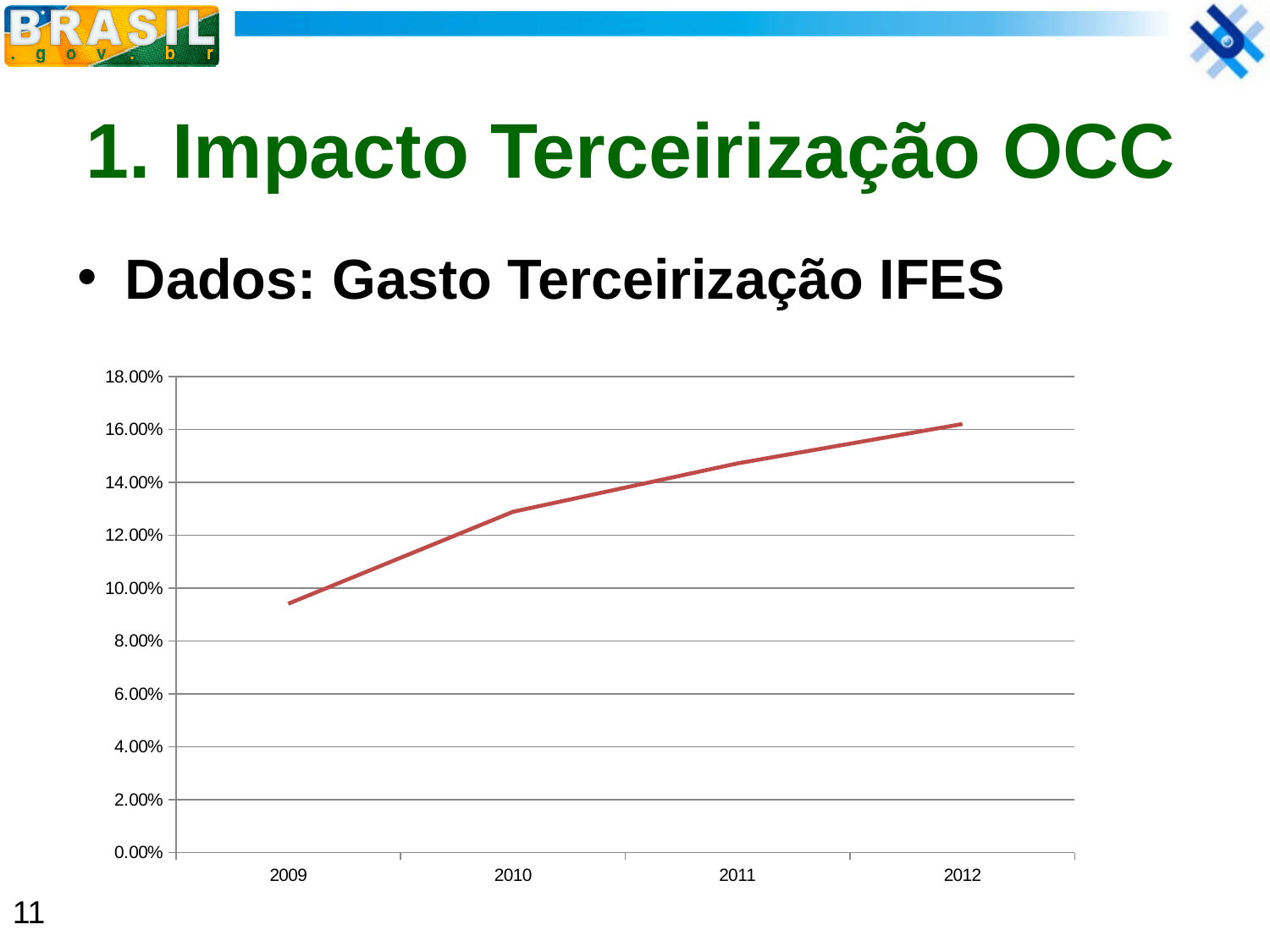
Is the value for 2009 greater or less than 10.00%? less Is the value for 2010 greater or less than 14.00%? less How many years are plotted on the x axis of the chart? 4 What kind of chart is shown on the slide? line chart Which is larger, the value for 2010 or the value for 2012? 2012 Is the value for 2011 greater or less than 14.00%? greater Do the values rise or fall from 2009 to 2012? rise Which year has the lowest value in the chart? 2009 What is the highest value shown on the y axis of the chart? 18.00% Which year has the highest value in the chart? 2012